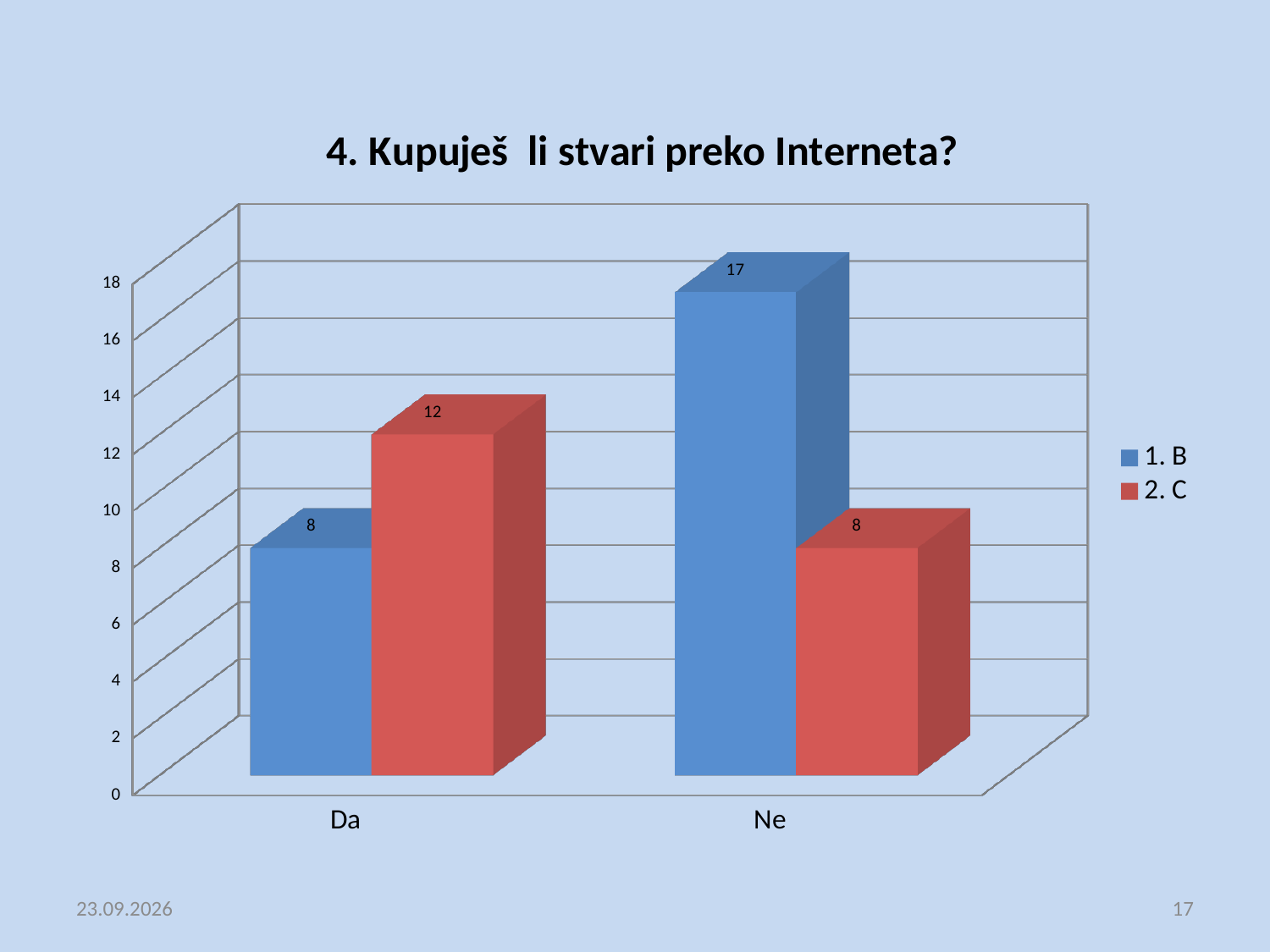
What is the title of the chart? 4. Kupuješ li stvari preko Interneta? What is the value for series 2. C in the Ne category? 8 What is the value for series 1. B in the Da category? 8 What is the value for series 2. C in the Da category? 12 How many categories are shown on the x axis? 2 Which category has the lowest value for series 2. C? Ne How many series does the legend list? 2 Which category has the highest value for series 1. B? Ne In the Da category, which series has the larger value, 1. B or 2. C? 2. C What is the value for series 1. B in the Ne category? 17 What is the difference between the 1. B and 2. C values in the Ne category? 9 What kind of chart is shown on the slide? Bar chart